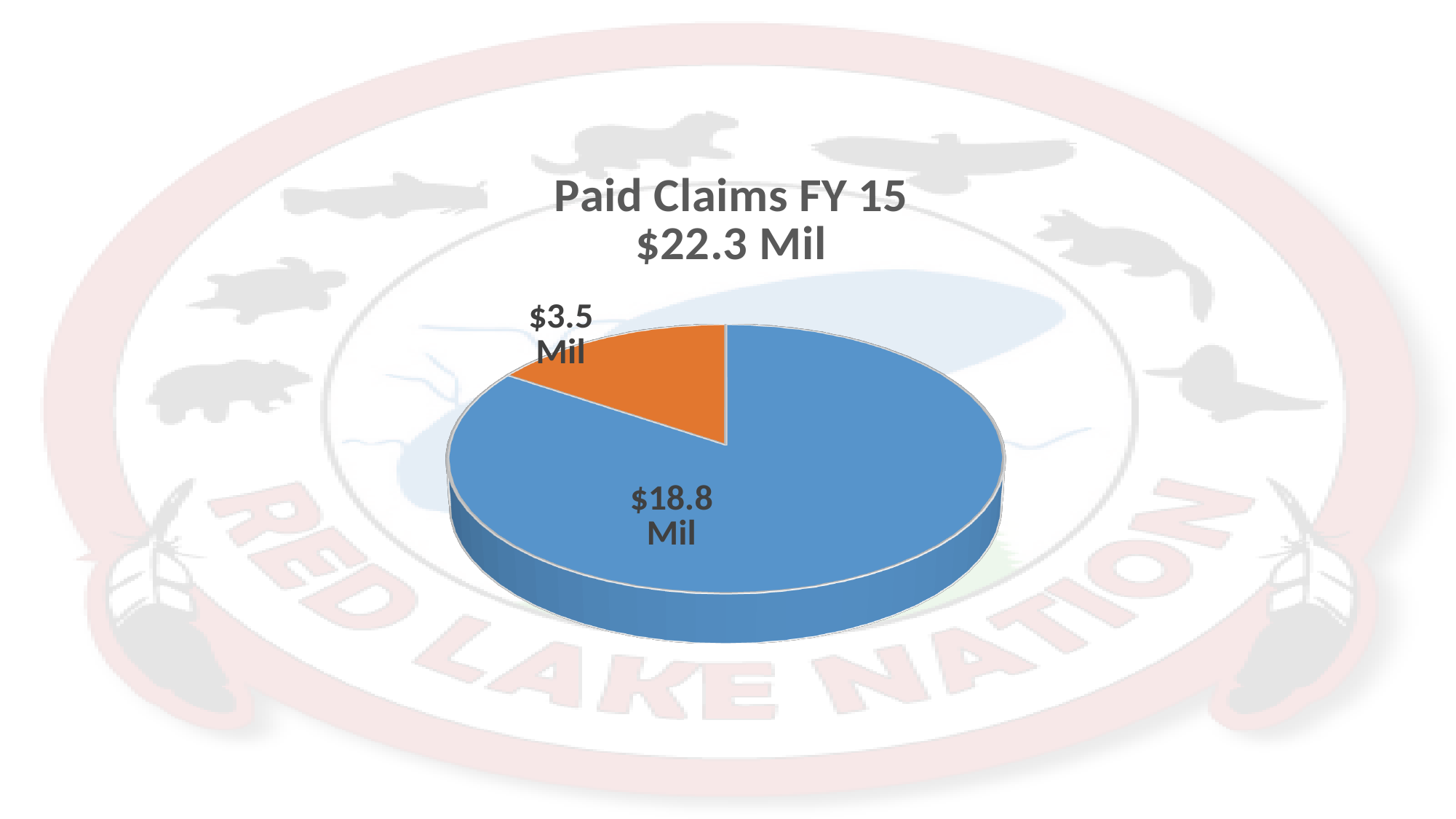
What is the total of the two slices in the pie chart? $22.3 Mil Which slice of the pie chart is the smallest? the orange slice ($3.5 Mil) What value is labelled on the blue slice of the pie chart? $18.8 Mil What value is labelled on the orange slice of the pie chart? $3.5 Mil What two colours are used for the slices of the pie chart? blue and orange Which is larger, the blue slice or the orange slice? the blue slice How many slices does the pie chart have? 2 What is the title of the chart? Paid Claims FY 15 $22.3 Mil Which slice of the pie chart is the largest? the blue slice ($18.8 Mil) What is the difference between the blue slice value and the orange slice value? $15.3 Mil What kind of chart is shown on the slide? pie chart